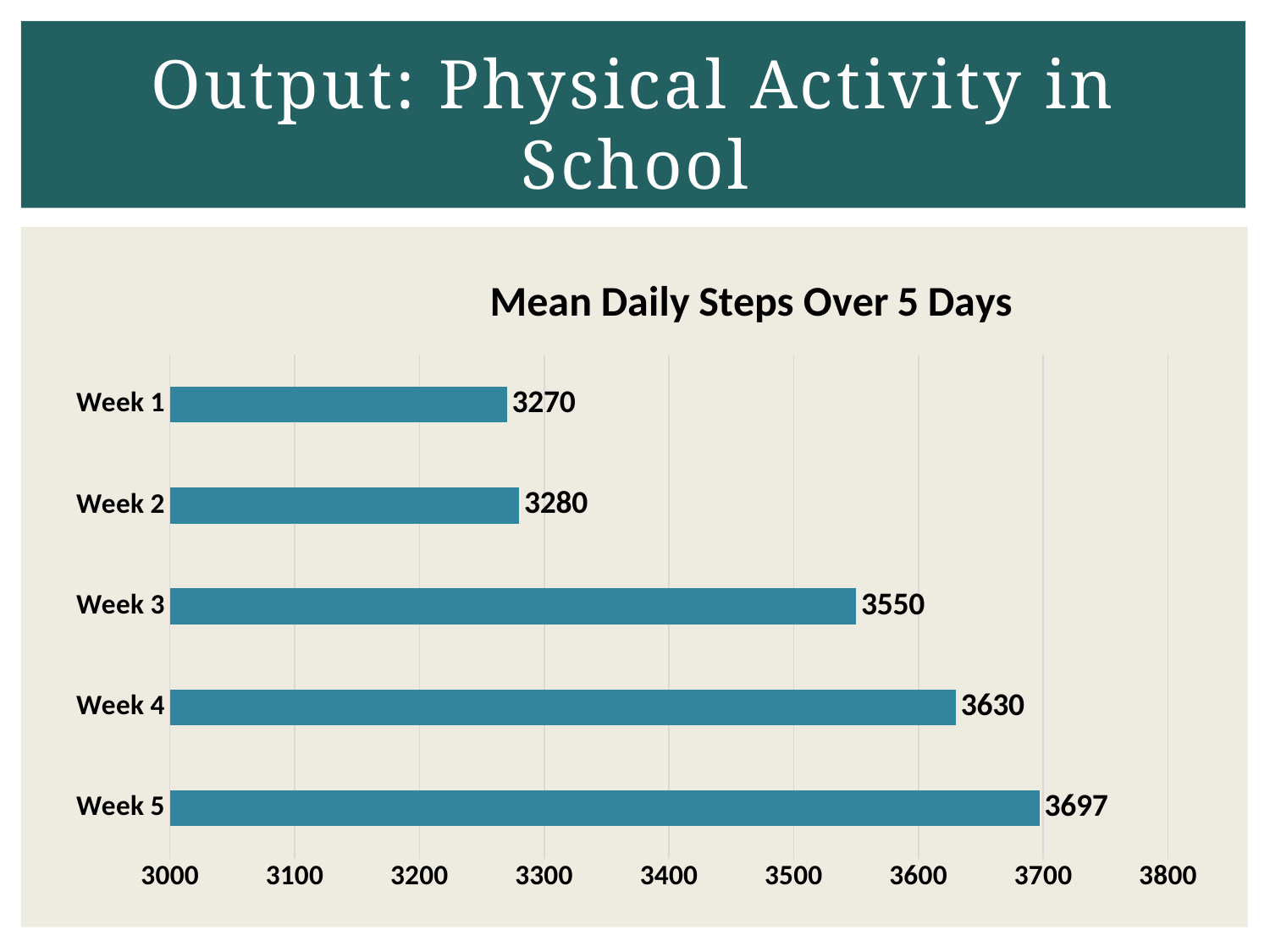
What is the mean daily steps value for Week 3? 3550 What is the title of the chart? Mean Daily Steps Over 5 Days Which week has the lowest mean daily steps? Week 1 How many weeks are shown in the chart? 5 Which has a higher mean daily steps value, Week 3 or Week 4? Week 4 What kind of chart is shown on the slide? Bar chart Which week has the highest mean daily steps? Week 5 What is the mean daily steps value for Week 1? 3270 What is the difference in mean daily steps between Week 5 and Week 1? 427 What is the difference in mean daily steps between Week 4 and Week 3? 80 What is the mean daily steps value for Week 5? 3697 Is the value for Week 2 greater or less than 3300? less